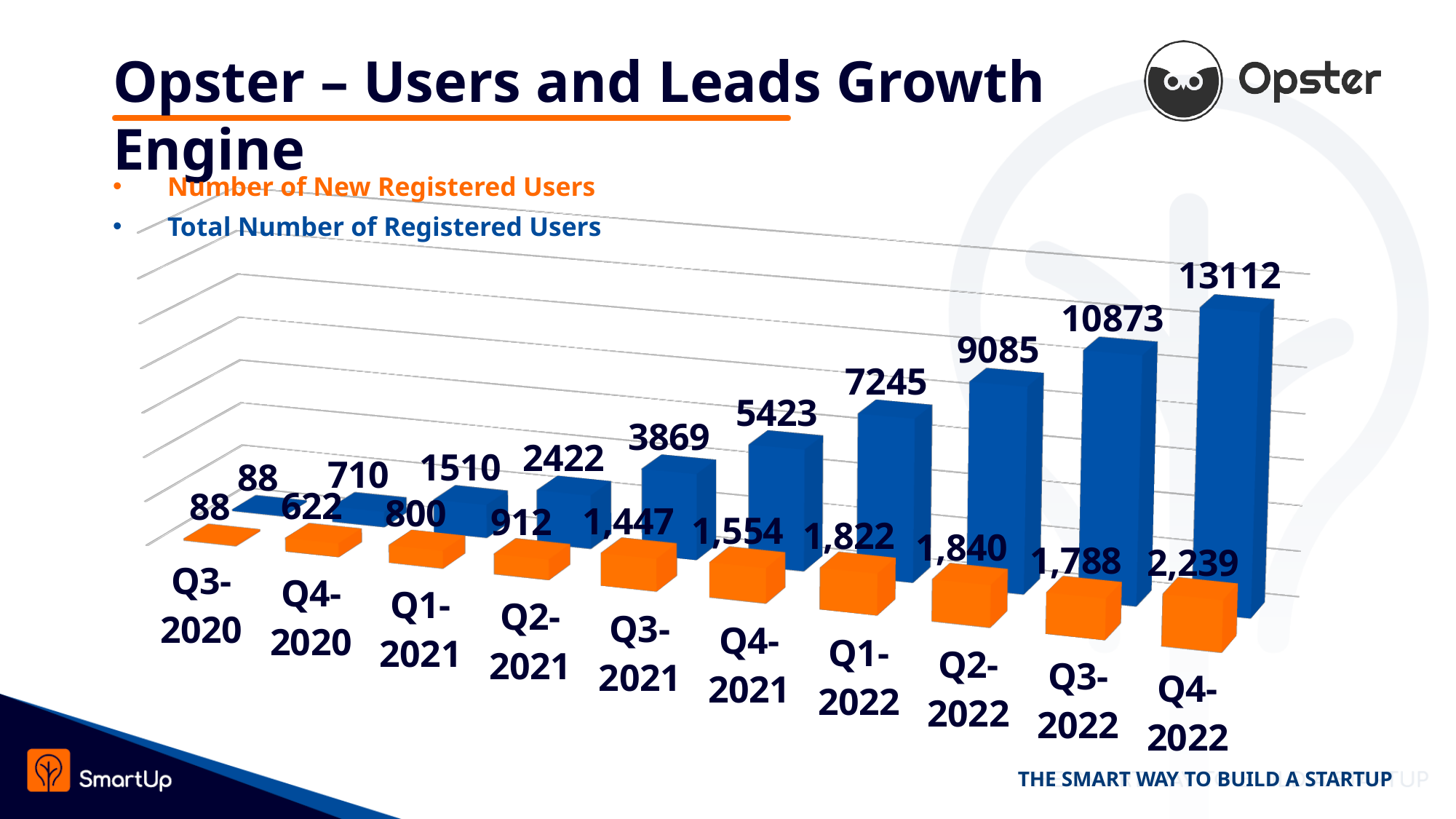
What kind of chart is shown on the slide? Bar chart Which quarter has the highest Number of New Registered Users? Q4-2022 Which quarter has the lowest Total Number of Registered Users? Q3-2020 Does the Total Number of Registered Users rise or fall from Q3-2020 to Q4-2022? Rise What is the difference between the Total Number of Registered Users in Q4-2022 and Q3-2022? 2239 How many quarters are shown on the x axis? 10 What is the Number of New Registered Users for Q3-2021? 1,447 Which is larger: the Number of New Registered Users in Q2-2022 or in Q3-2022? Q2-2022 What is the Number of New Registered Users for Q4-2020? 622 How many series does the legend list? 2 What is the Total Number of Registered Users for Q2-2021? 2422 What is the Total Number of Registered Users for Q4-2022? 13112